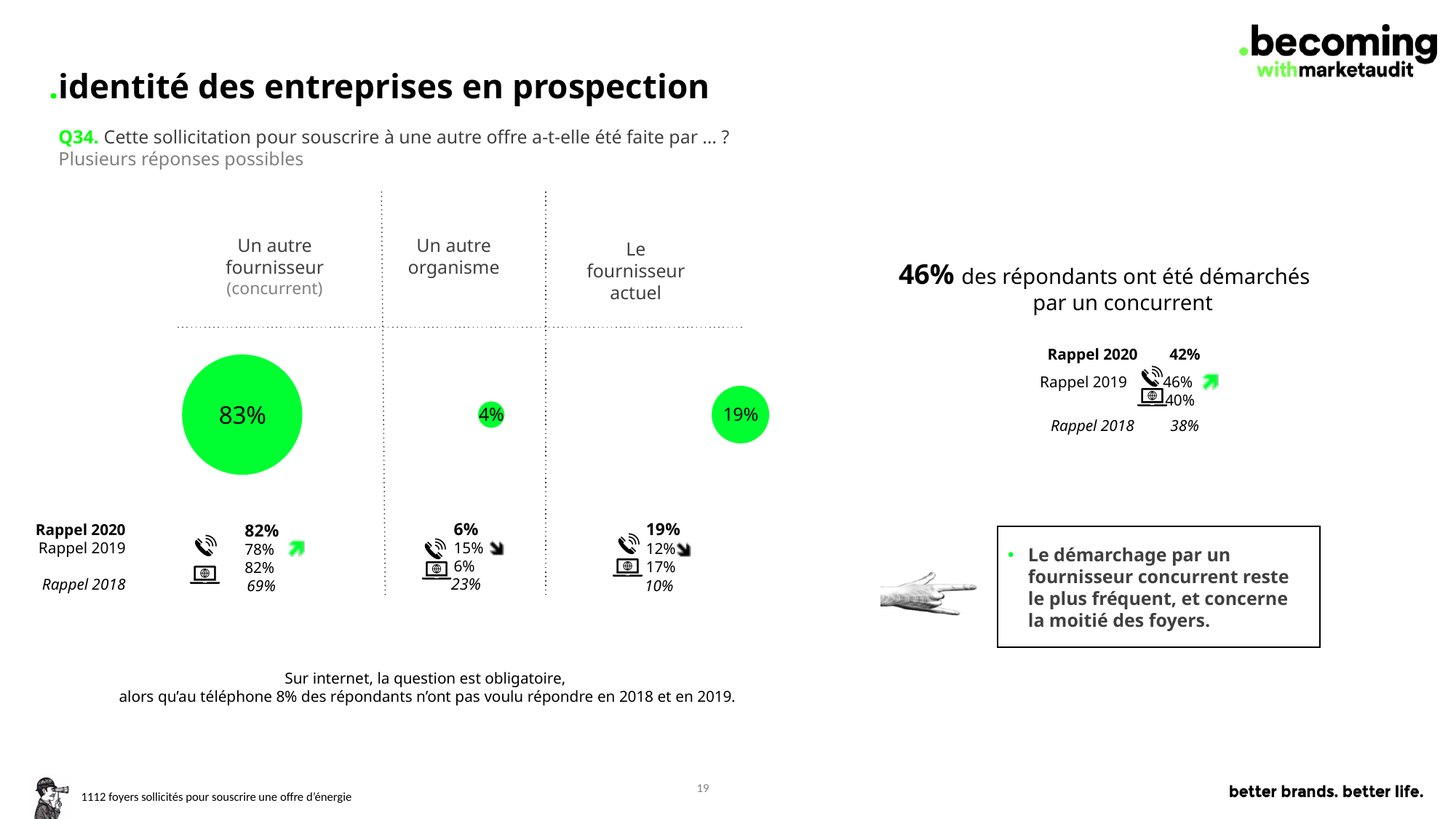
Which is larger: the value for "Le fournisseur actuel" or the value for "Un autre organisme"? Le fournisseur actuel What was the "Rappel 2020" value for "Un autre fournisseur (concurrent)"? 82% Which category has the highest value in the bubble chart? Un autre fournisseur (concurrent) What is the difference between the values for "Un autre fournisseur (concurrent)" and "Le fournisseur actuel"? 64% What is the value shown for "Un autre fournisseur (concurrent)" in the bubble chart? 83% What is the value shown for "Le fournisseur actuel" in the bubble chart? 19% What was the "Rappel 2018" value for "Un autre organisme"? 23% How many categories are shown in the bubble chart? 3 What is the value shown for "Un autre organisme" in the bubble chart? 4% What was the "Rappel 2020" value for "Le fournisseur actuel"? 19% What percentage of respondents were approached by a competitor, according to the text on the right of the slide? 46% Which category has the lowest value in the bubble chart? Un autre organisme